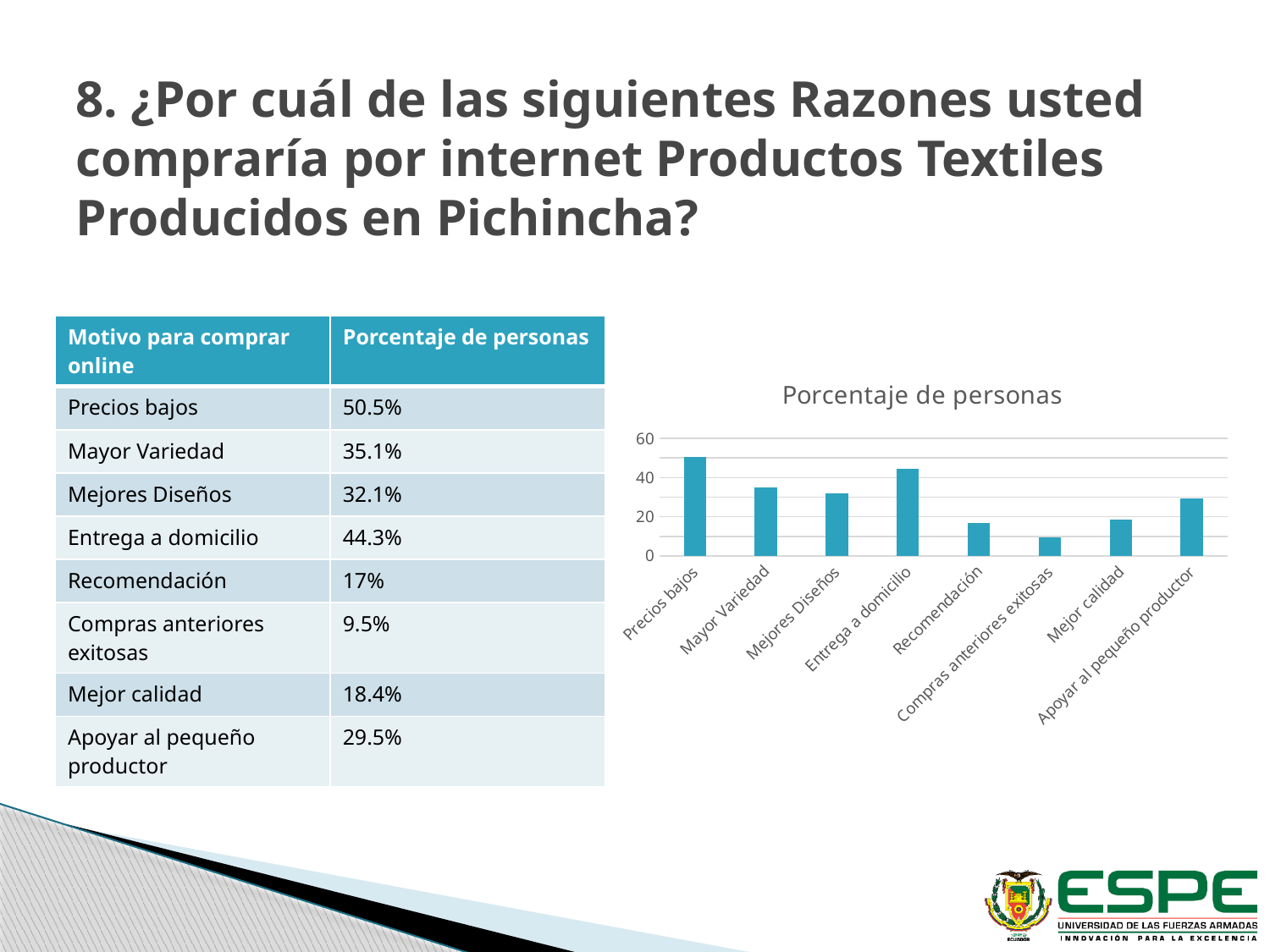
What is the value for Entrega a domicilio? 44.3% What is the value for Apoyar al pequeño productor? 29.5% What is the value for Precios bajos? 50.5% Which is larger, the value for Mayor Variedad or the value for Mejores Diseños? Mayor Variedad How many categories are plotted in the chart? 8 Which category has the lowest value in the chart? Compras anteriores exitosas What is the difference between the values for Precios bajos and Entrega a domicilio? 6.2% What type of chart is shown on the slide? bar chart What is the difference between the values for Mejor calidad and Compras anteriores exitosas? 8.9% Which category has the highest value in the chart? Precios bajos What is the title of the chart? Porcentaje de personas Is the value for Recomendación greater or less than 20? less